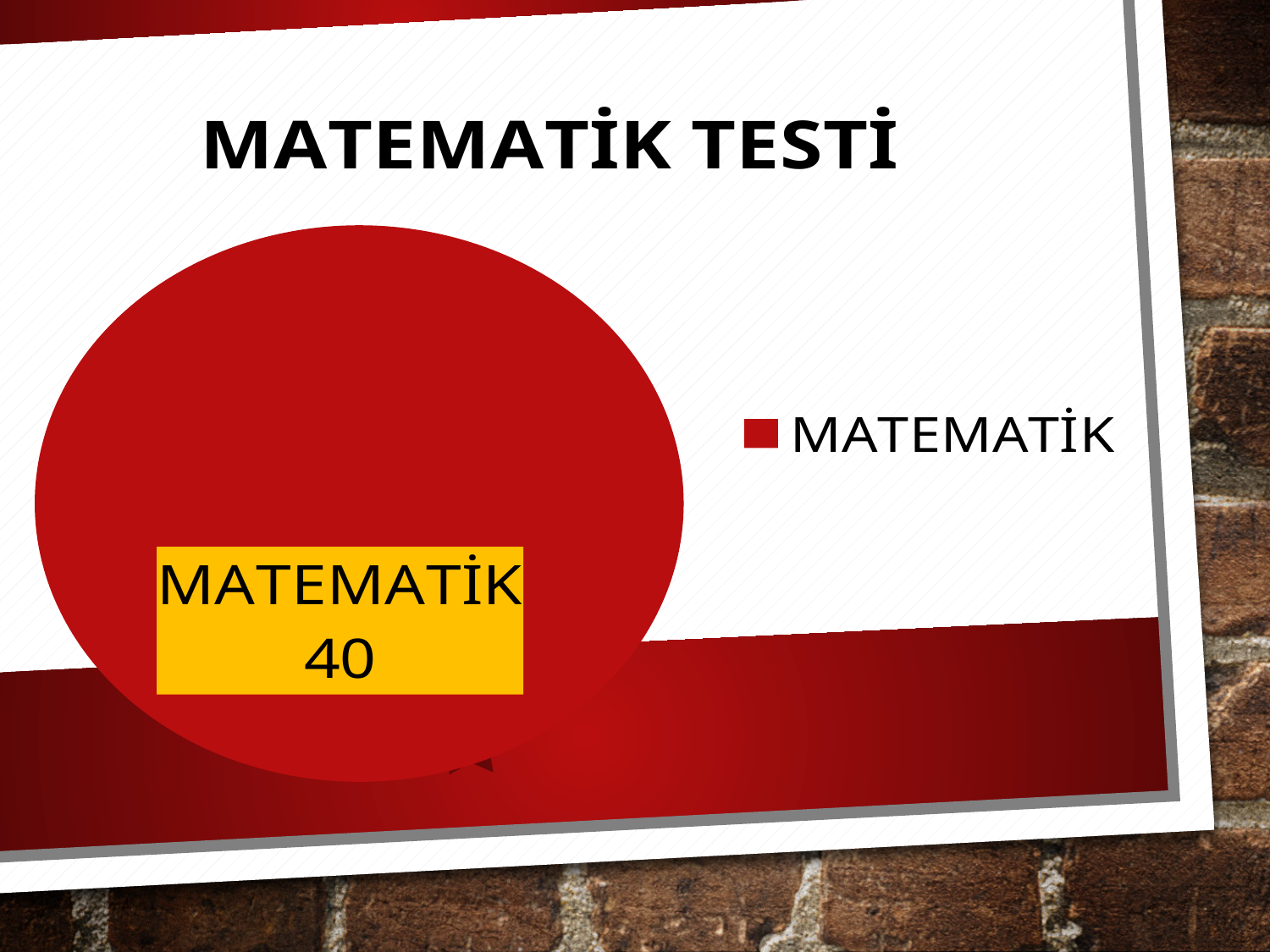
How many slices does the pie chart have? 1 How many entries does the chart legend list? 1 What is the value shown for MATEMATİK in the pie chart? 40 What kind of chart is shown on the slide? pie chart What is the title of the chart? MATEMATİK TESTİ What colour is the MATEMATİK slice in the pie chart? red Which category is the largest in the pie chart? MATEMATİK